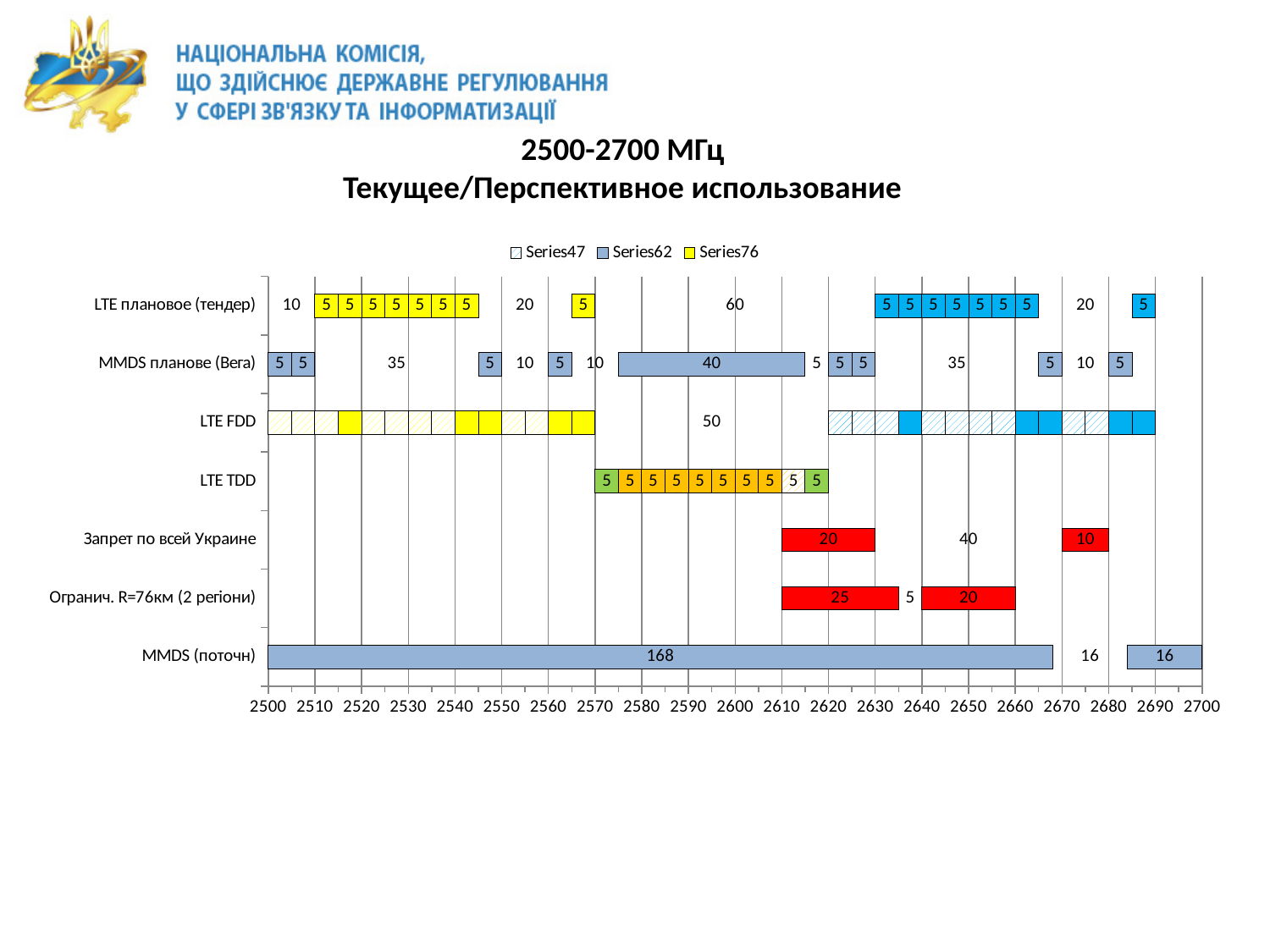
What kind of chart is shown on the slide? bar chart What is the title of the chart? 2500-2700 МГц Текущее/Перспективное использование What value is printed on the first red segment of the Огранич. R=76км (2 регіони) bar? 25 How many series does the chart legend list? 3 What are the minimum and maximum values shown on the horizontal axis? 2500 and 2700 What is the value printed on the largest segment of the MMDS (поточн) bar? 168 How many categories are listed on the vertical axis of the chart? 7 What is the difference between the two red segments (25 and 20) of the Огранич. R=76км (2 регіони) bar? 5 What value is printed on the LTE FDD bar? 50 Which is larger: the first red segment of Запрет по всей Украине or the first red segment of Огранич. R=76км (2 регіони)? Огранич. R=76км (2 регіони) What is the total of the three labelled segments (168, 16, 16) of the MMDS (поточн) bar? 200 What value is printed on the first red segment of the Запрет по всей Украине bar? 20